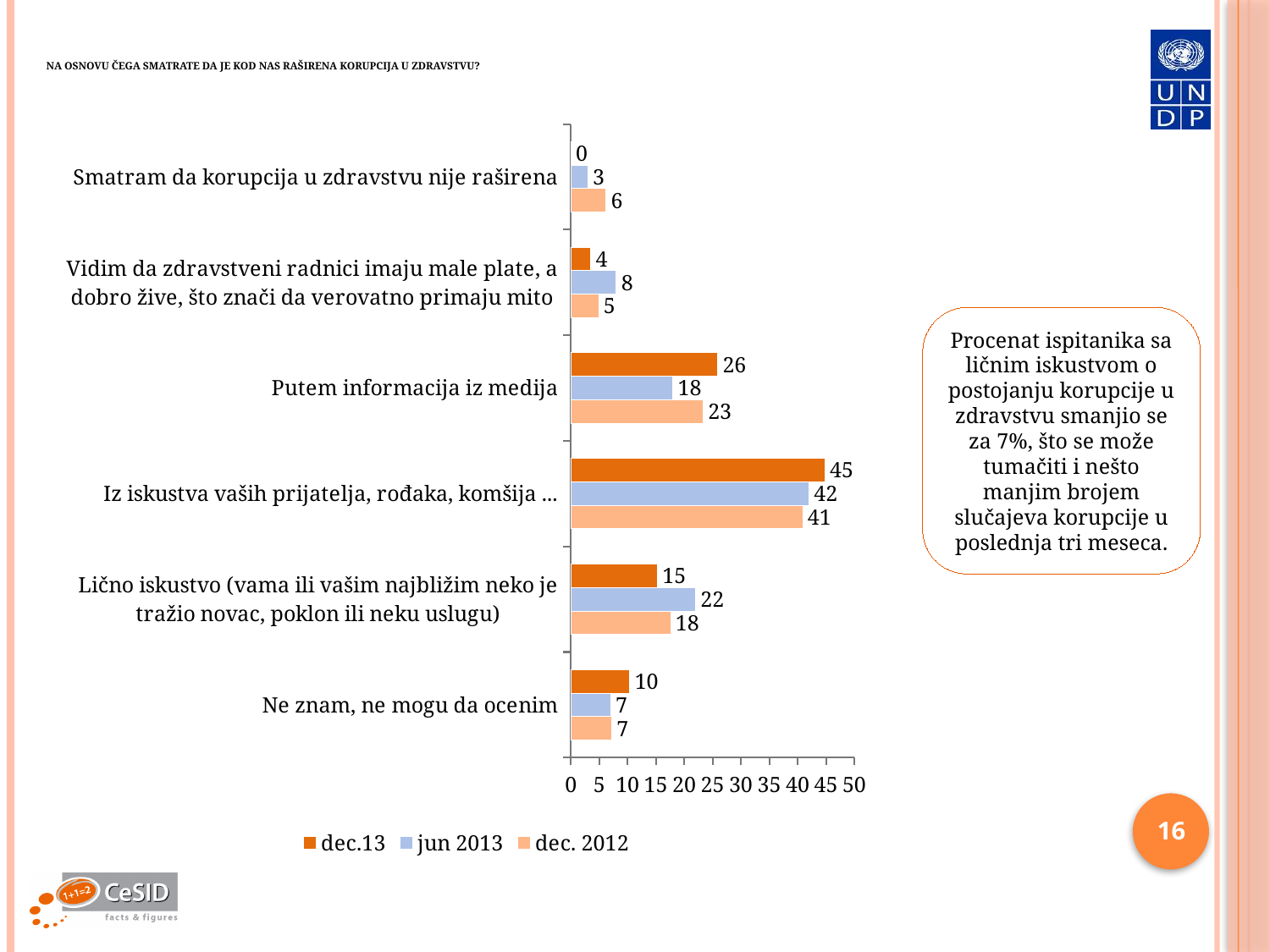
What is the jun 2013 value for "Lično iskustvo (vama ili vašim najbližim neko je tražio novac, poklon ili neku uslugu)"? 22 What is the dec. 2012 value for "Smatram da korupcija u zdravstvu nije raširena"? 6 What is the dec.13 value for "Putem informacija iz medija"? 26 How many series does the legend list? 3 Which category has the lowest dec.13 value? Smatram da korupcija u zdravstvu nije raširena How many categories are shown on the chart? 6 Which series is shown in dark orange in the legend? dec.13 What is the dec.13 value for "Ne znam, ne mogu da ocenim"? 10 For "Putem informacija iz medija", which is larger: the dec.13 value or the dec. 2012 value? dec.13 Which category has the highest dec.13 value? Iz iskustva vaših prijatelja, rođaka, komšija ... What kind of chart is shown on the slide? Bar chart What is the difference between the jun 2013 and dec.13 values for "Lično iskustvo (vama ili vašim najbližim neko je tražio novac, poklon ili neku uslugu)"? 7